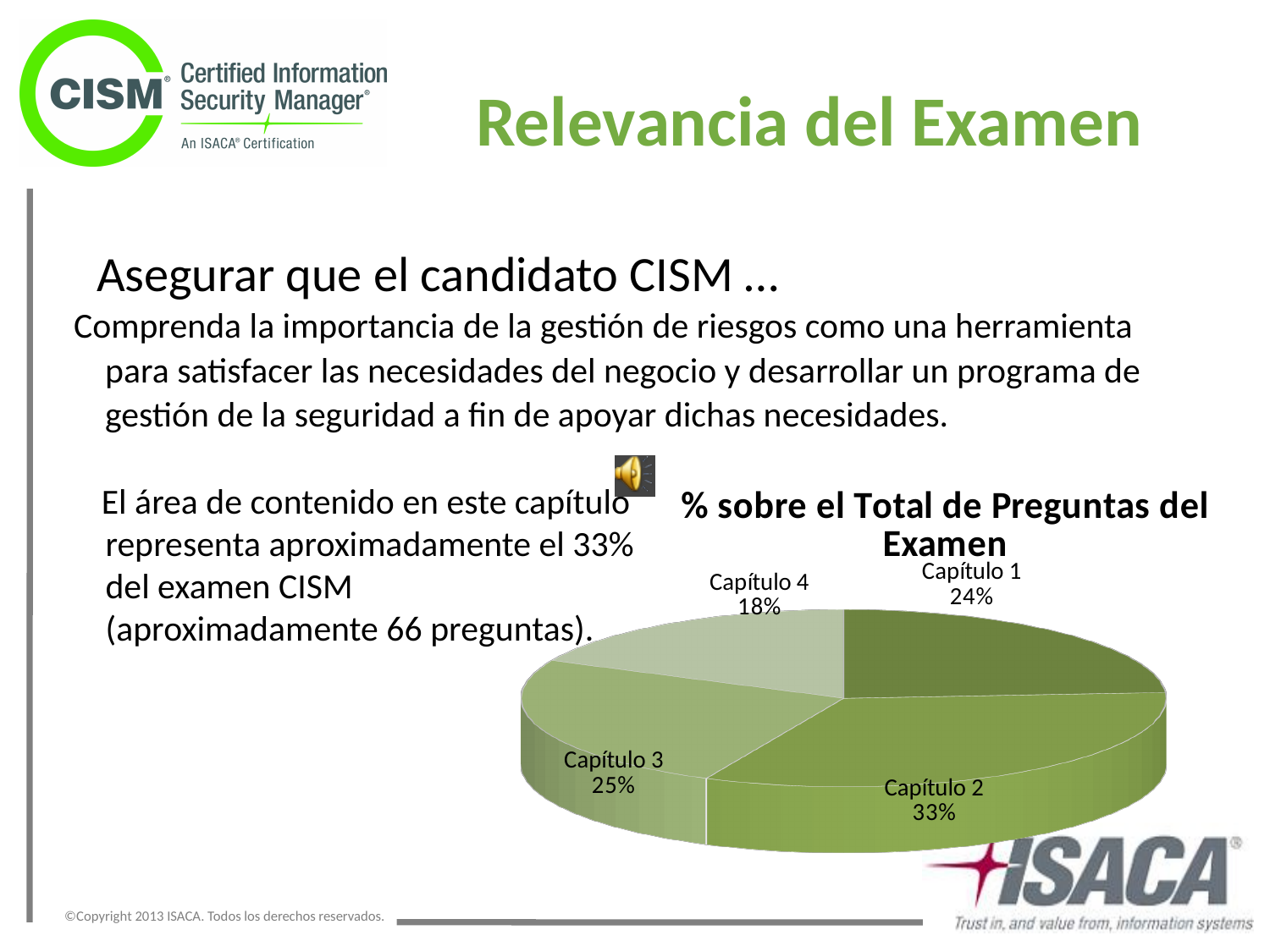
Which chapter has the largest share of the exam questions? Capítulo 2 How many chapters (slices) are shown in the pie chart? 4 What is the combined share of Capítulo 1 and Capítulo 2? 57% Which has a larger share, Capítulo 1 or Capítulo 3? Capítulo 3 What percentage does Capítulo 2 represent in the chart? 33% What percentage does Capítulo 3 represent in the chart? 25% What percentage does Capítulo 1 represent in the chart? 24% Which chapter has the smallest share of the exam questions? Capítulo 4 What is the title of the chart? % sobre el Total de Preguntas del Examen What kind of chart is shown on the slide? Pie chart What is the difference in percentage points between Capítulo 2 and Capítulo 4? 15 What percentage does Capítulo 4 represent in the chart? 18%